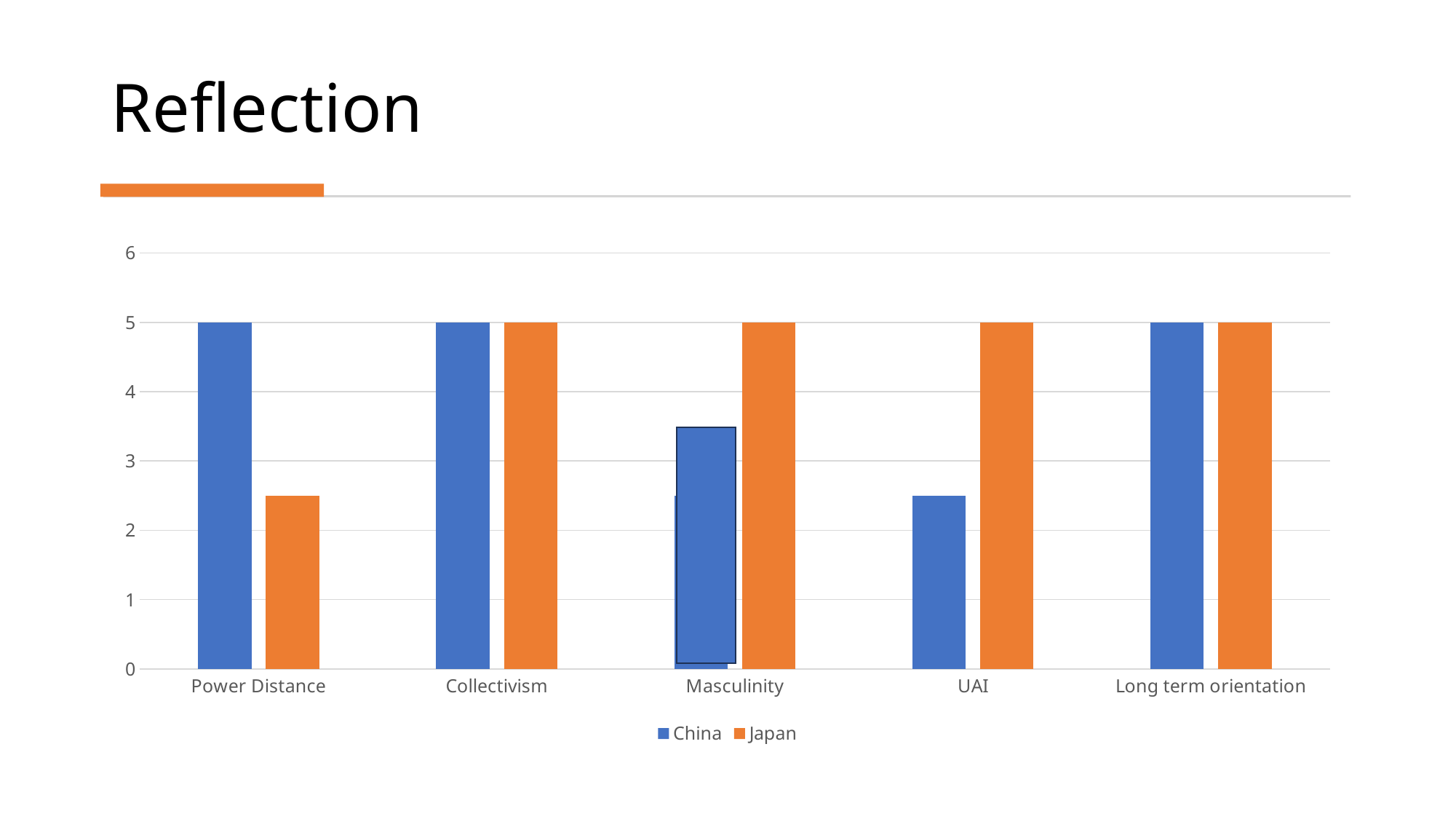
What is the value for Japan in the Collectivism category? 5 Which category has the lowest value for Japan? Power Distance Is the value for China in UAI greater or less than 2? greater How many series does the legend list? 2 What is the value for China in the Power Distance category? 5 How many categories are shown on the x axis? 5 In the UAI category, which is larger, China or Japan? Japan In the Power Distance category, which is larger, China or Japan? China Is the value for Japan in Power Distance greater or less than 3? less What kind of chart is shown on the slide? bar chart